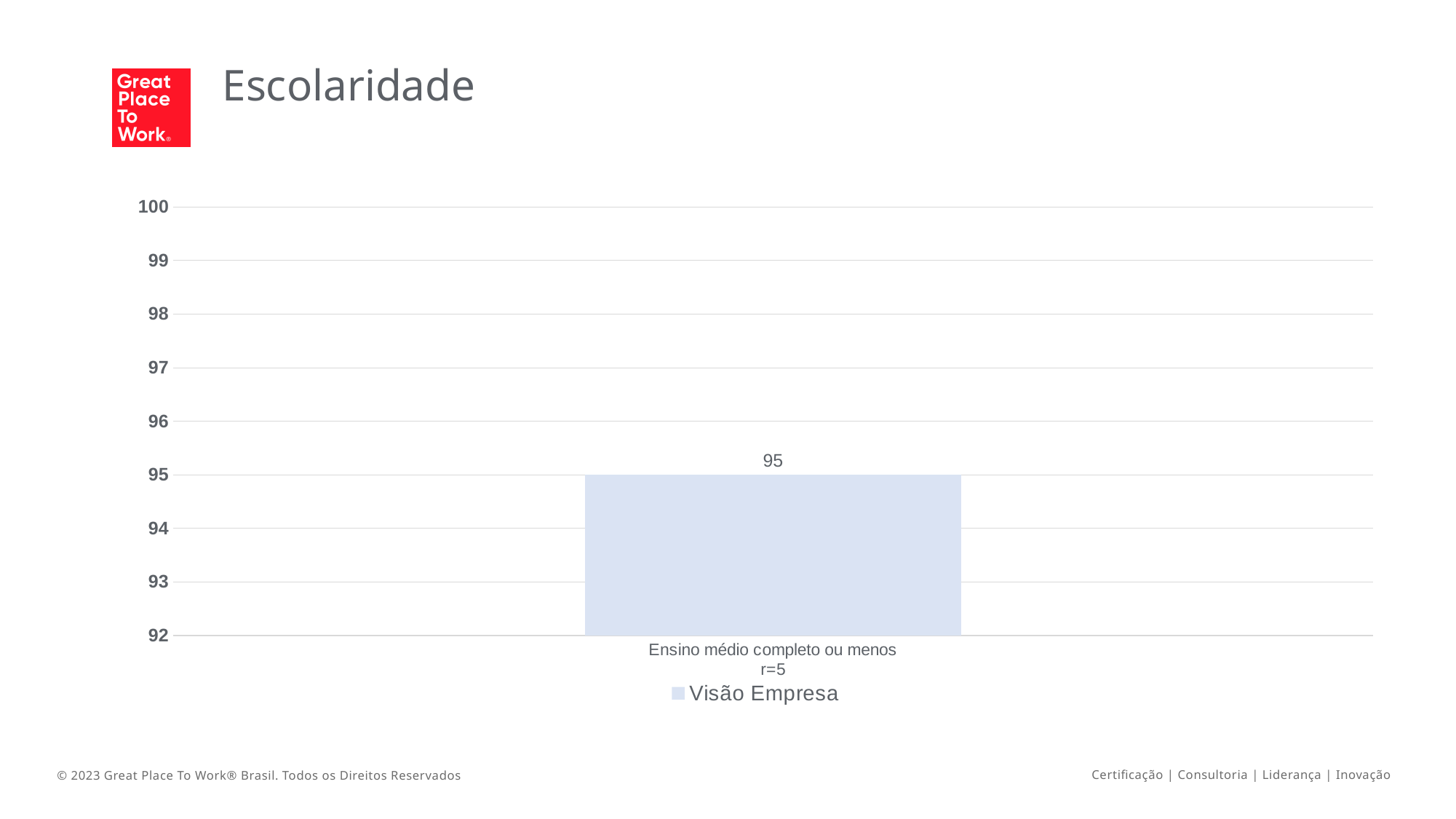
What is the title of the slide containing the chart? Escolaridade What is the lowest value shown on the y axis? 92 What is the respondent count (r) shown under the category label? r=5 What kind of chart is shown on the slide? bar chart How many series does the legend list? 1 Is the value for 'Ensino médio completo ou menos' greater or less than 96? less What is the value for 'Ensino médio completo ou menos' in the Visão Empresa series? 95 Is the value for 'Ensino médio completo ou menos' greater or less than 94? greater What is the highest value shown on the y axis? 100 What is the name of the series shown in the legend? Visão Empresa How many categories are plotted on the x axis? 1